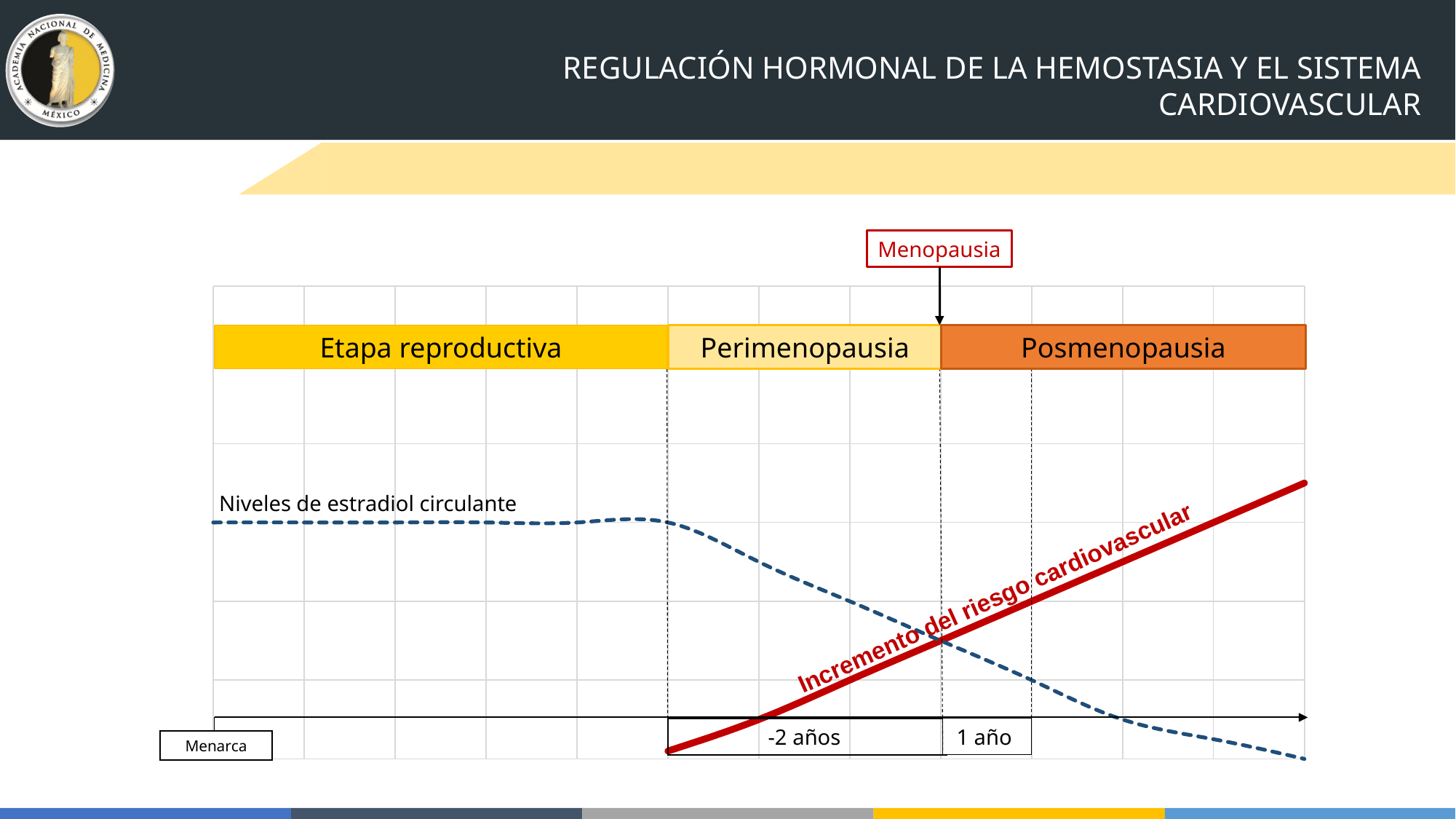
How many lines are plotted on the chart? 2 What are the three stages labelled in the coloured band across the chart? Etapa reproductiva, Perimenopausia, Posmenopausia Is the dashed estradiol line flat or declining during the 'Etapa reproductiva' stage? Flat What time label is shown on the x axis for the interval just after menopause? 1 año What kind of chart is shown on the slide? Line chart Which stage does the 'Menopausia' arrow point to the start of? Posmenopausia Does the dashed line for 'Niveles de estradiol circulante' rise or fall along the x axis after the reproductive stage? Fall What time label is shown on the x axis for the perimenopause interval before menopause? -2 años How many life stages are labelled in the coloured band across the top of the chart? 3 What label marks the start of the x axis at the left of the chart? Menarca Which stage is shown in the orange band on the right of the chart? Posmenopausia Does the red line labelled 'Incremento del riesgo cardiovascular' rise or fall along the x axis? Rise